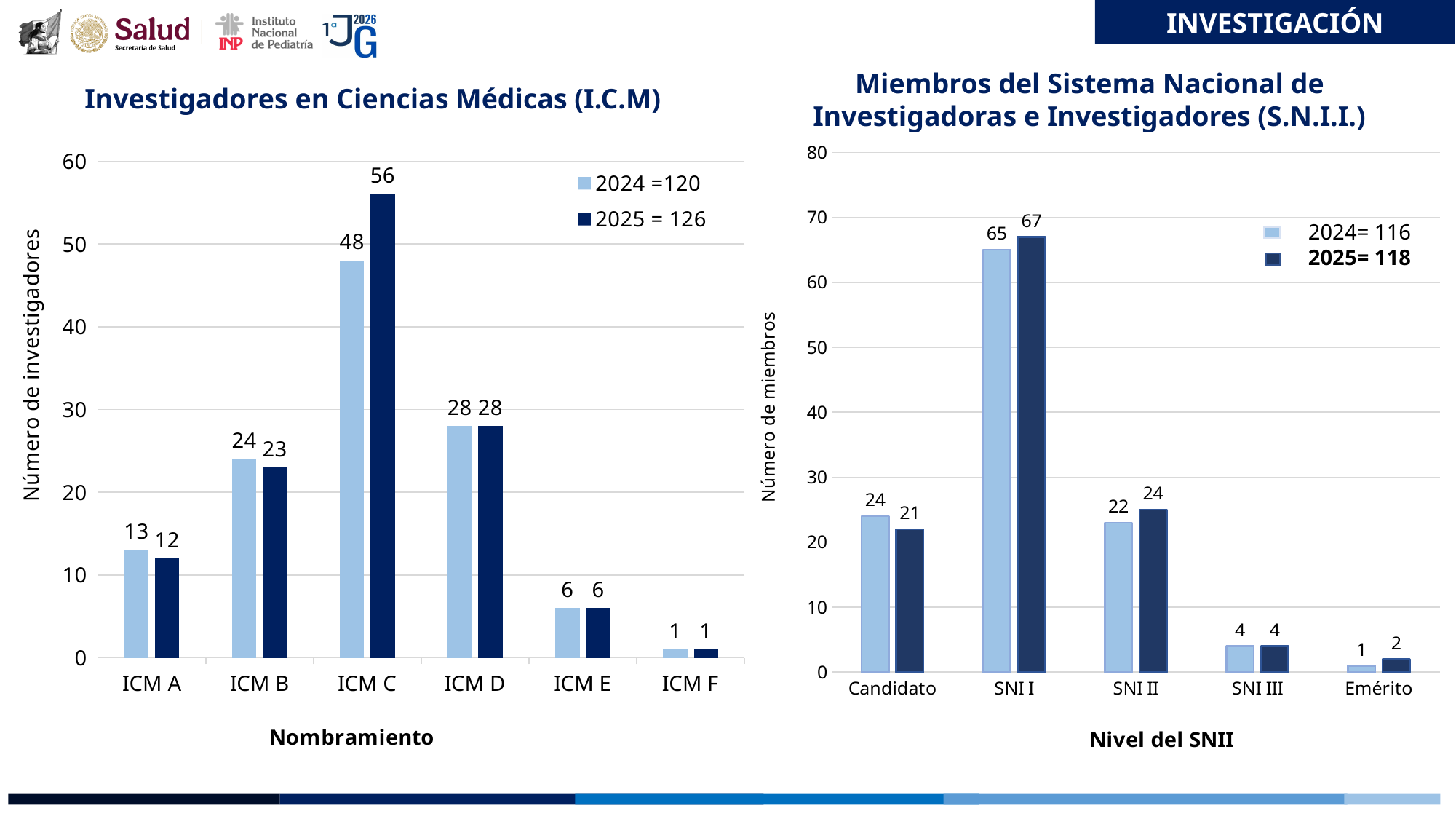
In the 'Investigadores en Ciencias Médicas (I.C.M)' chart, how many categories are shown on the x axis? 6 In the 'Investigadores en Ciencias Médicas (I.C.M)' chart, which category has the highest value in 2024? ICM C In the 'Investigadores en Ciencias Médicas (I.C.M)' chart, what is the difference between the 2025 and 2024 values for ICM C? 8 What kind of chart is the 'Miembros del Sistema Nacional de Investigadoras e Investigadores (S.N.I.I.)' chart? Bar chart In the 'Miembros del Sistema Nacional de Investigadoras e Investigadores (S.N.I.I.)' chart, which is larger for SNI II: the 2024 value or the 2025 value? 2025 In the 'Investigadores en Ciencias Médicas (I.C.M)' chart, what is the value for ICM C in 2025? 56 In the 'Miembros del Sistema Nacional de Investigadoras e Investigadores (S.N.I.I.)' chart, what is the value for Candidato in 2024? 24 In the 'Investigadores en Ciencias Médicas (I.C.M)' chart, what is the value for ICM B in 2024? 24 In the 'Investigadores en Ciencias Médicas (I.C.M)' chart, which category has the lowest value in 2025? ICM F In the 'Miembros del Sistema Nacional de Investigadoras e Investigadores (S.N.I.I.)' chart, what is the value for SNI I in 2025? 67 In the 'Miembros del Sistema Nacional de Investigadoras e Investigadores (S.N.I.I.)' chart, what is the difference between the 2024 and 2025 values for Candidato? 3 In the 'Investigadores en Ciencias Médicas (I.C.M)' chart, how many series does the legend list? 2